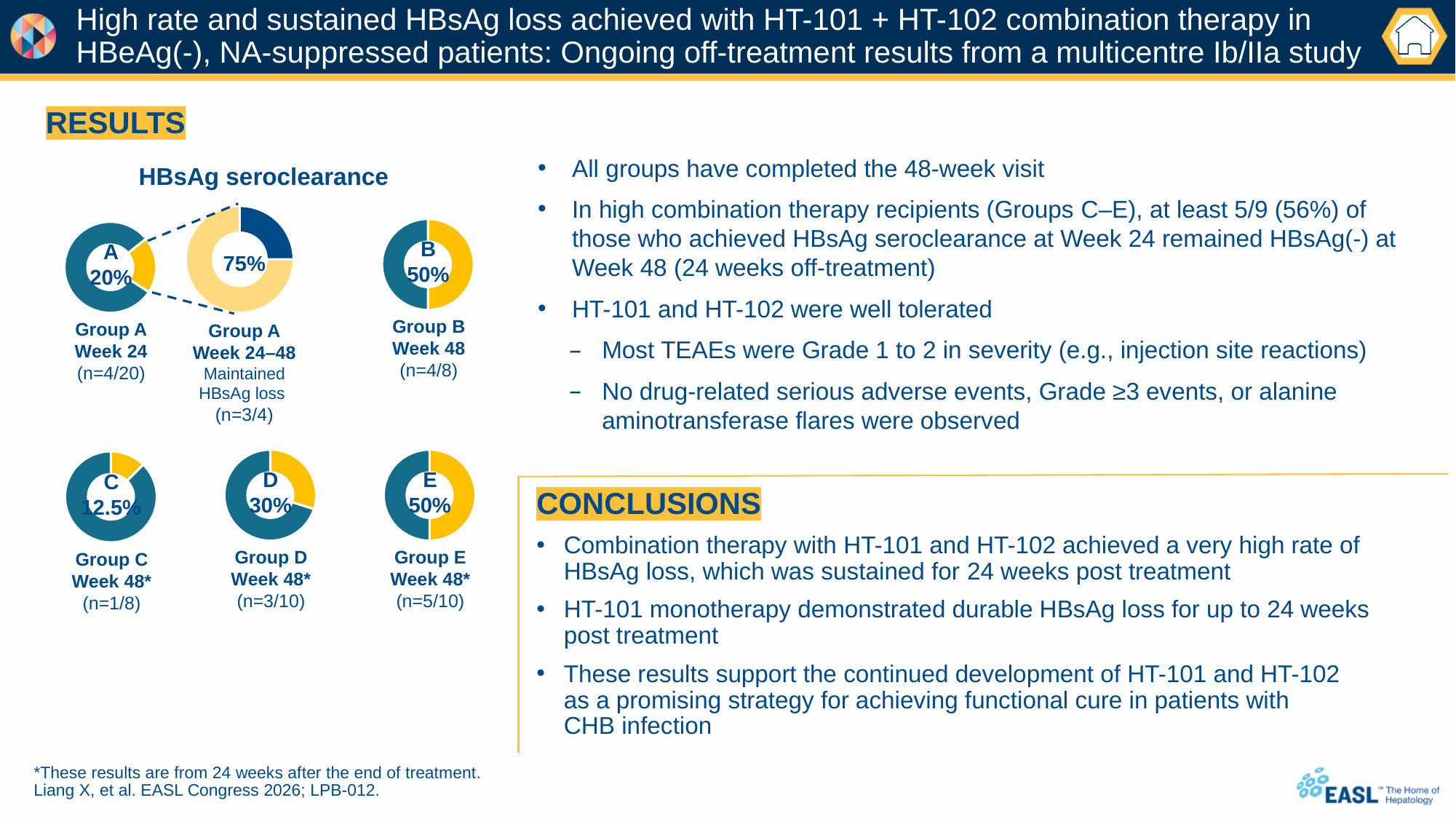
In the HBsAg seroclearance charts, which is larger: the Group A Week 24 percentage or the Group D Week 48 percentage? Group D Week 48 In the HBsAg seroclearance charts, what percentage is shown in the Group A Week 24 donut chart? 20% In the HBsAg seroclearance charts, what is the n value shown under the Group E Week 48 chart? n=5/10 What kind of chart is used to show HBsAg seroclearance on the slide? Donut (pie) chart In the HBsAg seroclearance charts, what percentage is shown for Group B at Week 48? 50% In the HBsAg seroclearance charts, what percentage is shown for Group D at Week 48? 30% Among the Week 48 donut charts for Groups B, C, D and E, which group has the lowest HBsAg seroclearance percentage? Group C In the HBsAg seroclearance charts, what is the difference in percentage between Group D Week 48 and Group C Week 48? 17.5% How many donut charts are shown under the HBsAg seroclearance heading? 6 Among the Week 48 donut charts for Groups C, D and E, which group has the highest HBsAg seroclearance percentage? Group E In the HBsAg seroclearance charts, what percentage is shown in the Group A Week 24–48 Maintained HBsAg loss donut chart? 75% In the HBsAg seroclearance charts, what percentage is shown for Group C at Week 48? 12.5%